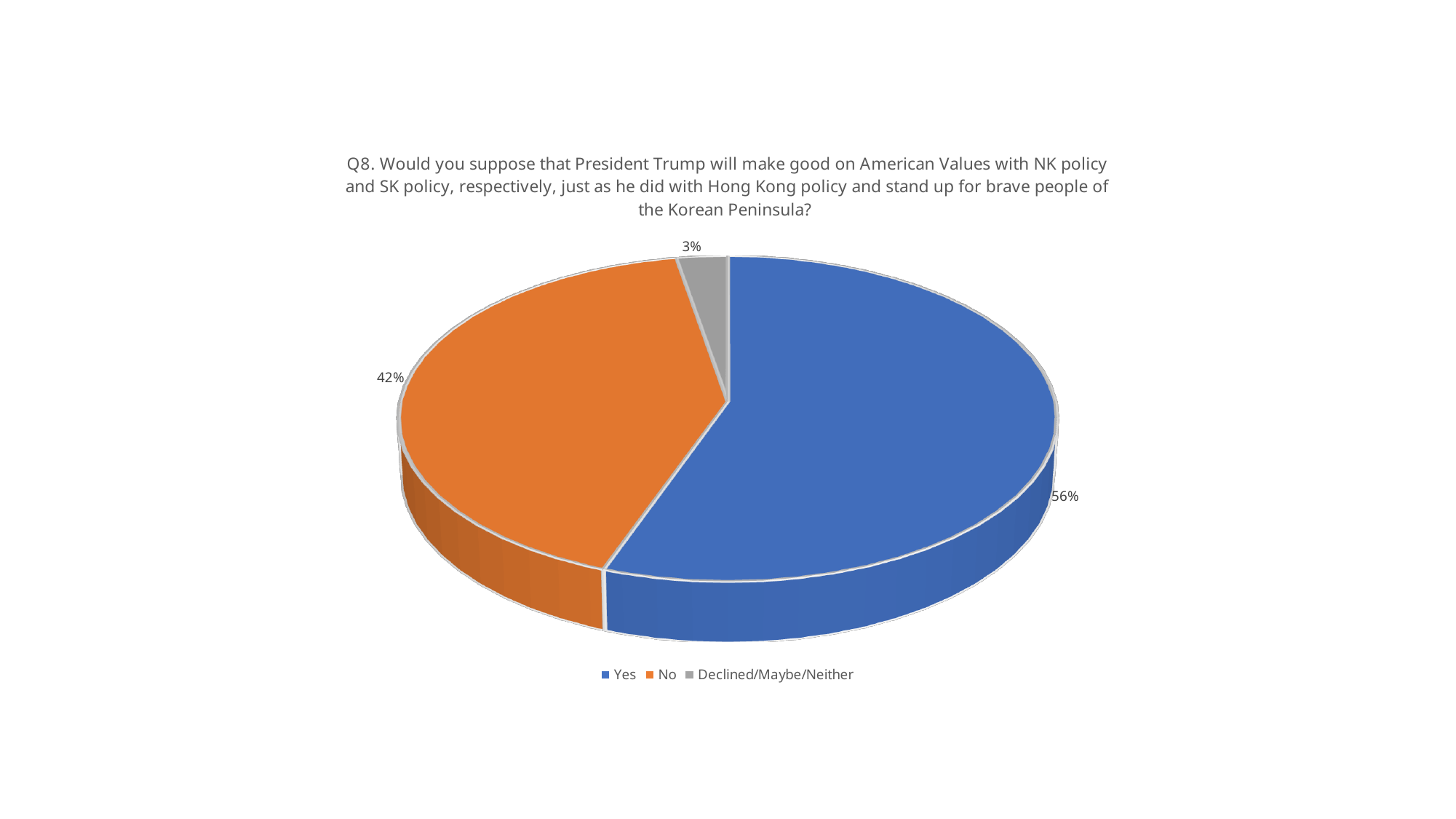
Is the share for No greater or less than 50%? less Which response category has the smallest share of the pie? Declined/Maybe/Neither How many categories does the pie chart show? 3 Which response category has the largest share of the pie? Yes Which is larger, the share for Yes or the share for No? Yes What is the third entry listed in the legend? Declined/Maybe/Neither What percentage of respondents answered Yes? 56% What is the difference in percentage points between the Yes and No shares? 14 What percentage of respondents answered No? 42% What kind of chart is shown on the slide? Pie chart What colour is the Yes slice? Blue What percentage of respondents are in the Declined/Maybe/Neither category? 3%